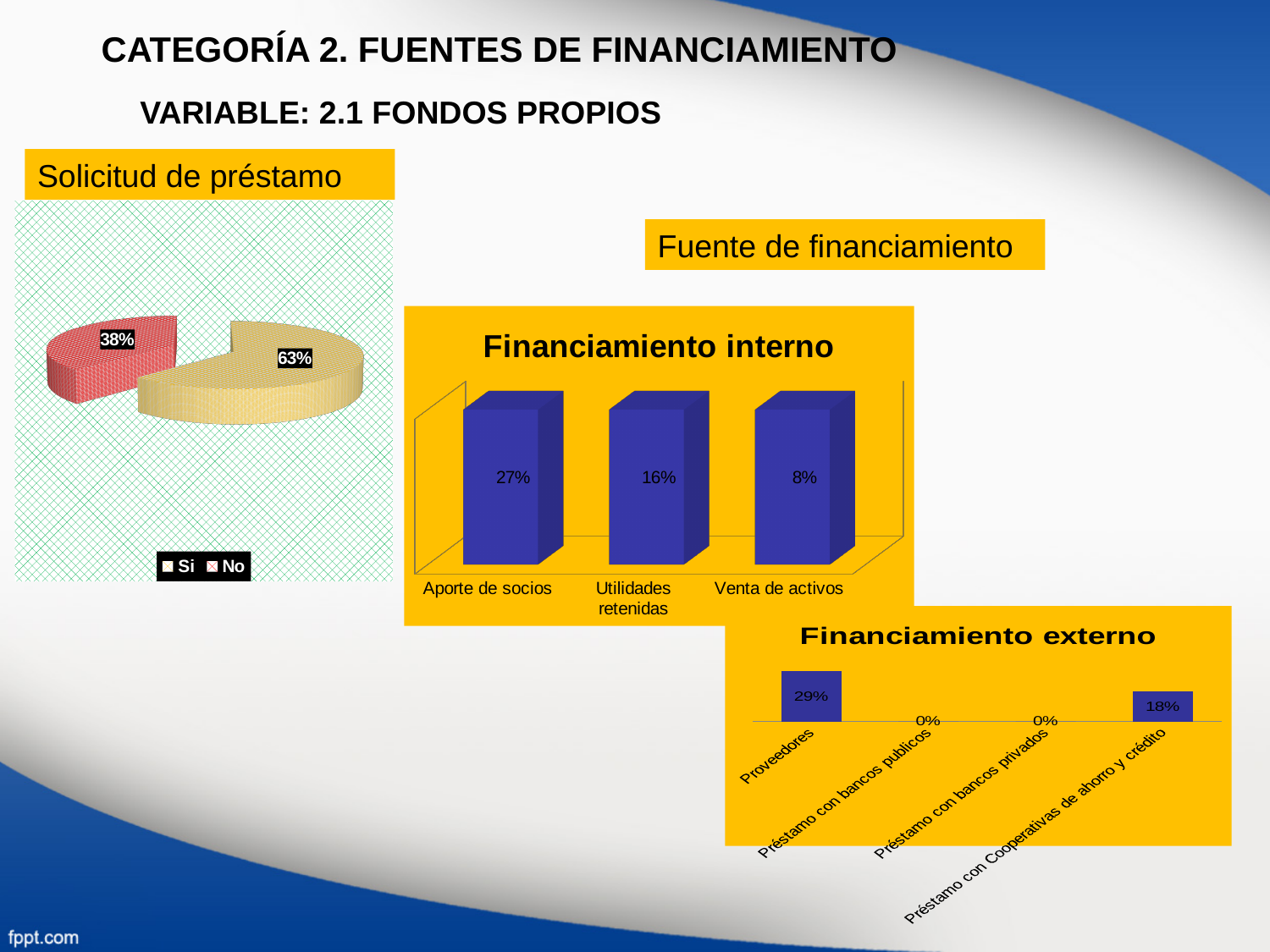
In the 'Financiamiento externo' chart, what is the value for 'Proveedores'? 29% In the 'Financiamiento interno' chart, what is the value for 'Aporte de socios'? 27% In the 'Financiamiento interno' chart, what is the difference between 'Aporte de socios' and 'Venta de activos'? 19% In the 'Solicitud de préstamo' pie chart, what percentage is shown for the 'No' slice? 38% How many categories are shown in the 'Financiamiento externo' chart? 4 In the 'Solicitud de préstamo' pie chart, what percentage is shown for the 'Si' slice? 63% What kind of chart is the 'Solicitud de préstamo' chart? Pie chart In the 'Financiamiento interno' chart, what is the value for 'Utilidades retenidas'? 16% In the 'Financiamiento interno' chart, which category has the lowest value? Venta de activos How many categories are shown in the 'Financiamiento interno' chart? 3 In the 'Financiamiento externo' chart, what is the value for 'Préstamo con Cooperativas de ahorro y crédito'? 18% In the 'Financiamiento externo' chart, which category has the highest value? Proveedores